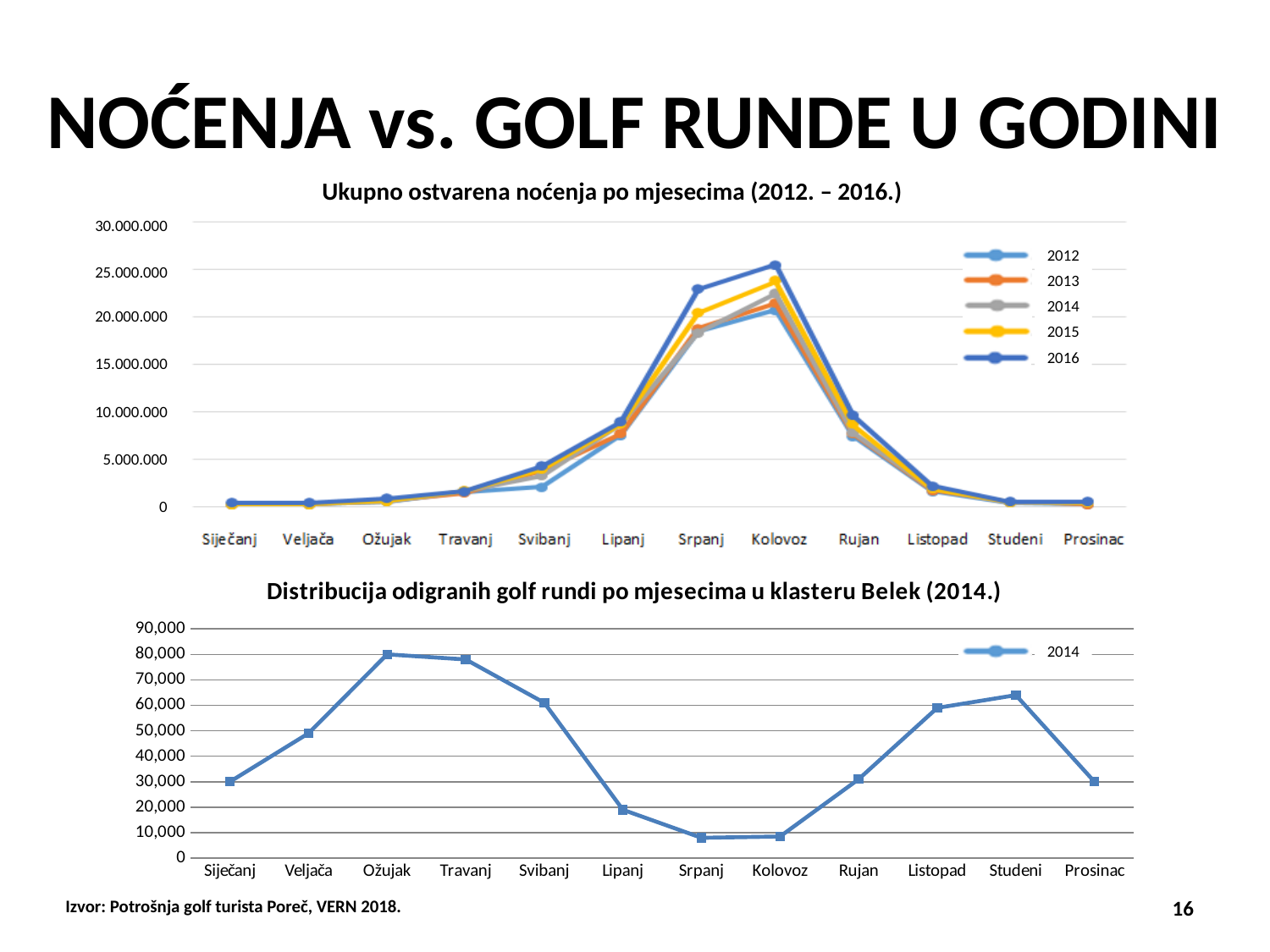
In the chart titled "Distribucija odigranih golf rundi po mjesecima u klasteru Belek (2014.)", how many series does the legend list? 1 What kind of chart is the chart titled "Distribucija odigranih golf rundi po mjesecima u klasteru Belek (2014.)"? line chart In the chart titled "Ukupno ostvarena noćenja po mjesecima (2012. – 2016.)", how many series does the legend list? 5 In the chart titled "Ukupno ostvarena noćenja po mjesecima (2012. – 2016.)", is the value for 2012 in Svibanj greater or less than 5.000.000? less In the chart titled "Ukupno ostvarena noćenja po mjesecima (2012. – 2016.)", how many months are shown on the x axis? 12 In the chart titled "Distribucija odigranih golf rundi po mjesecima u klasteru Belek (2014.)", is the value for Svibanj greater or less than 50,000? greater In the chart titled "Ukupno ostvarena noćenja po mjesecima (2012. – 2016.)", in which month do all series reach their highest value? Kolovoz In the chart titled "Distribucija odigranih golf rundi po mjesecima u klasteru Belek (2014.)", is the value for Srpanj greater or less than 10,000? less In the chart titled "Ukupno ostvarena noćenja po mjesecima (2012. – 2016.)", which series has the larger value in Srpanj, 2012 or 2016? 2016 In the chart titled "Distribucija odigranih golf rundi po mjesecima u klasteru Belek (2014.)", which month has the highest value? Ožujak In the chart titled "Distribucija odigranih golf rundi po mjesecima u klasteru Belek (2014.)", do the values rise or fall from Ožujak to Srpanj? fall